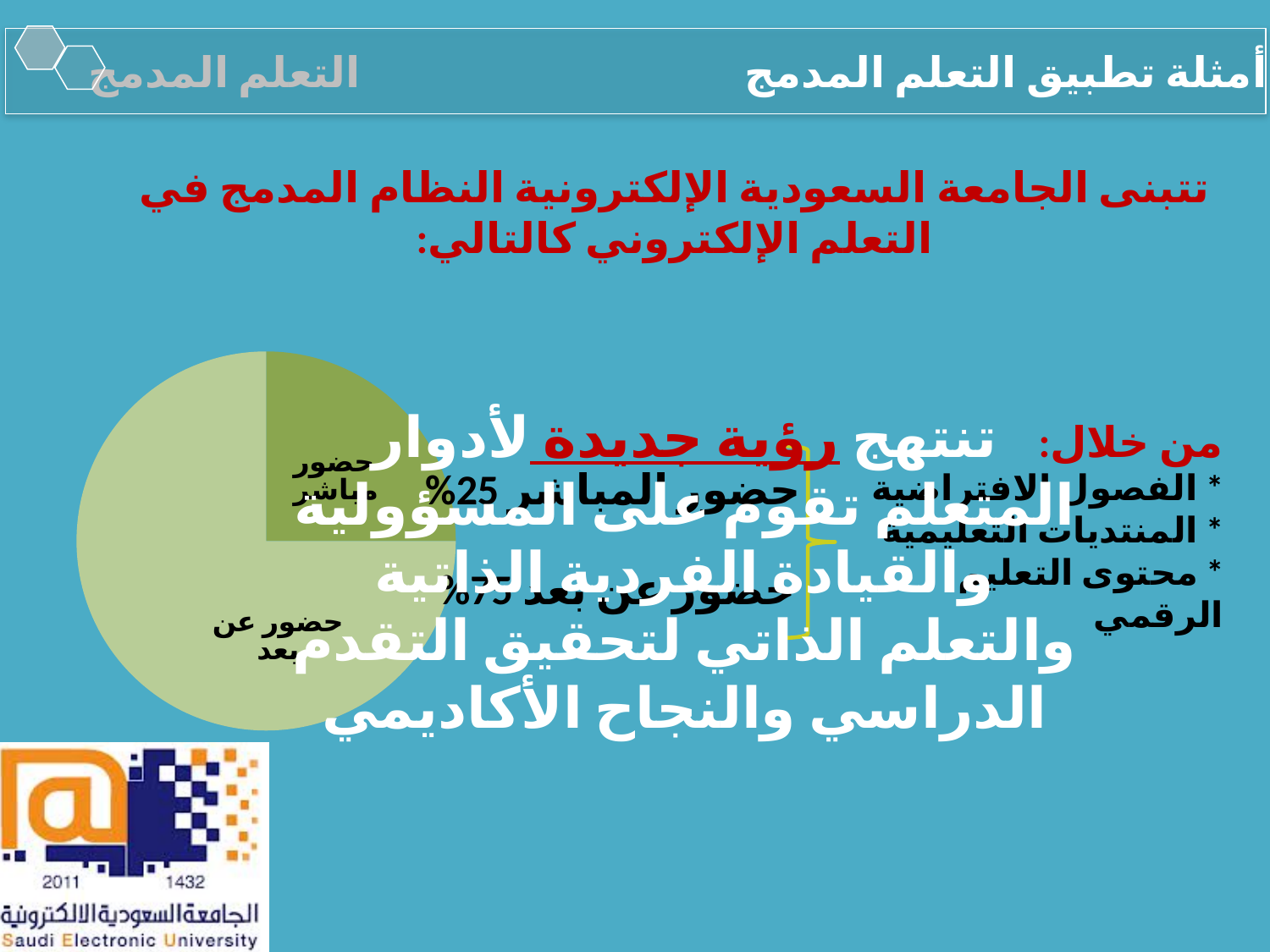
Is the share for حضور مباشر greater or less than 50%? less What share of the pie does حضور عن بعد take? 75% What kind of chart is shown on the slide? pie chart Which is larger, the slice for حضور مباشر or the slice for حضور عن بعد? حضور عن بعد What is the difference between the percentages for حضور عن بعد and حضور مباشر? 50% What percentage is shown for حضور مباشر? 25% What percentage is shown for حضور عن بعد? 75% Which slice of the pie chart is the largest? حضور عن بعد How many slices does the pie chart have? 2 Which slice of the pie chart is the smallest? حضور مباشر Which slice of the pie chart is drawn in the darker green colour? حضور مباشر